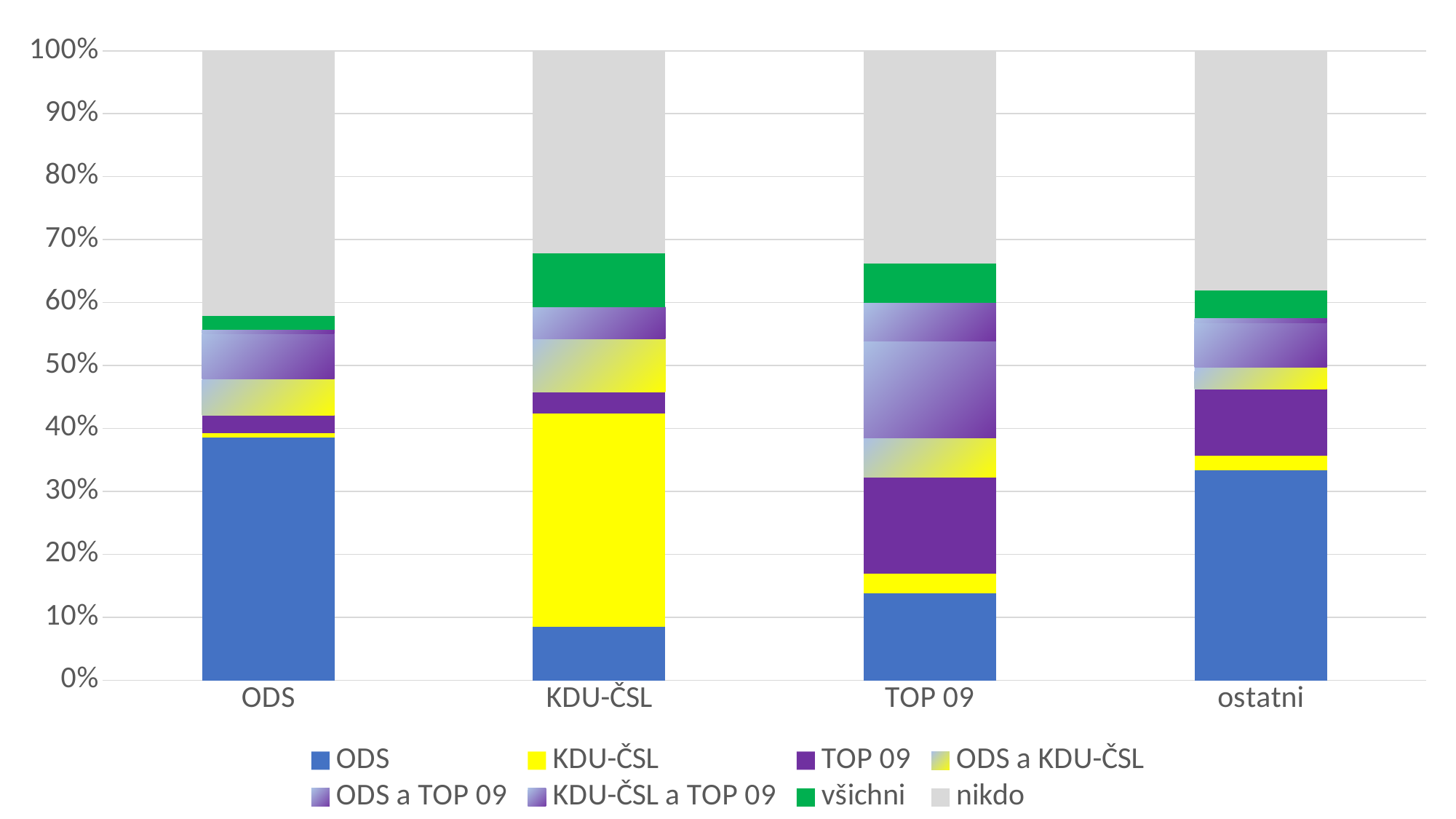
Is the value of the ODS series in the TOP 09 bar greater or less than 10%? greater Is the value of the ODS series in the KDU-ČSL bar greater or less than 10%? less How many categories are shown on the x axis? 4 Is the ODS segment larger in the ODS bar or in the TOP 09 bar? ODS What kind of chart is shown on the slide? stacked bar chart Which category has the largest ODS segment? ODS Which category has the smallest ODS segment? KDU-ČSL Is the value of the ODS series in the ODS bar greater or less than 30%? greater How many series does the legend list? 8 Which series is shown in grey in the legend? nikdo Which category has the largest nikdo segment? ODS